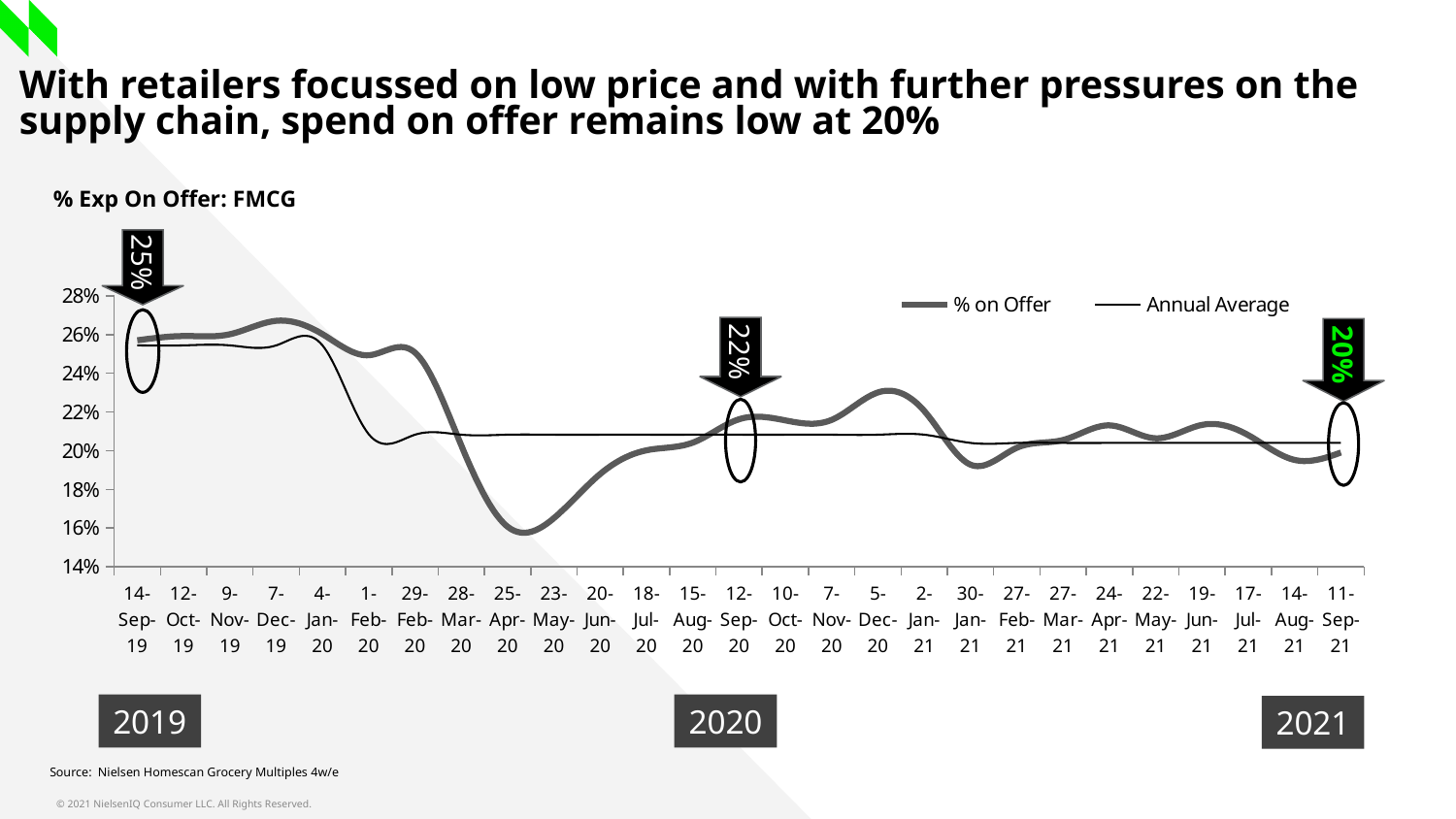
Is the % on Offer value at 23-May-20 greater or less than 18%? less What is the title of the chart? % Exp On Offer: FMCG What value is annotated in the arrow callout at 11-Sep-21? 20% Overall, does the % on Offer line rise or fall from 14-Sep-19 to 11-Sep-21? Fall What value is annotated in the arrow callout at 12-Sep-20? 22% What kind of chart is shown on the slide? Line chart How many series does the chart legend list? 2 By how many percentage points does the annotated value at 11-Sep-21 differ from the annotated value at 14-Sep-19? 5 percentage points What value is annotated in the arrow callout at 14-Sep-19? 25% At which date does the % on Offer line reach its lowest point? 25-Apr-20 What are the two series named in the chart legend? % on Offer and Annual Average How many dates are labelled along the x axis of the chart? 27